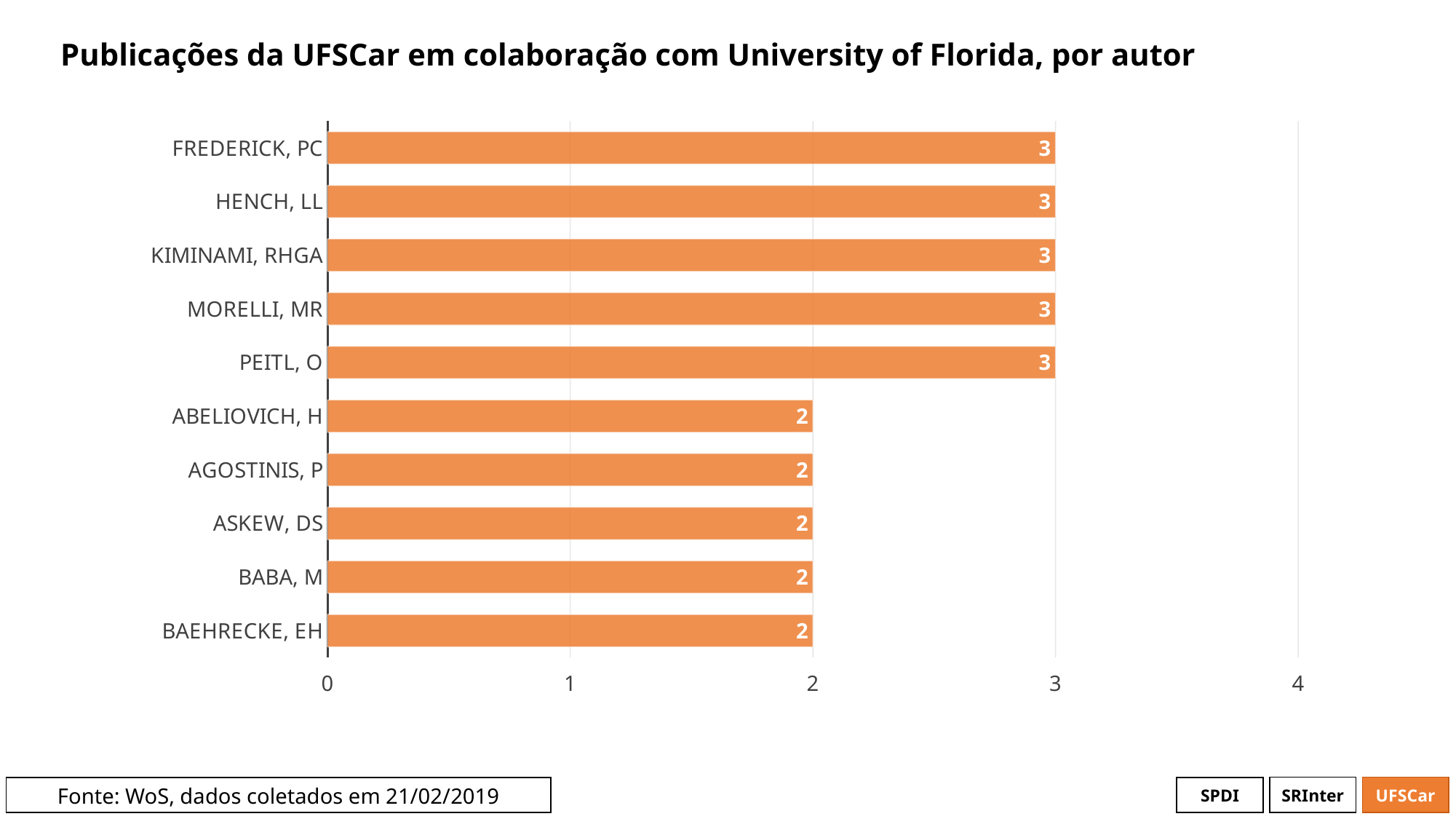
What is the value for PEITL, O? 3 What is the difference between the values for HENCH, LL and ASKEW, DS? 1 What kind of chart is shown on the slide? bar chart What colour are the bars in the chart? orange Is the value for KIMINAMI, RHGA greater or less than 2? greater What is the title of the chart? Publicações da UFSCar em colaboração com University of Florida, por autor Which is larger, the value for MORELLI, MR or the value for BABA, M? MORELLI, MR What is the value for FREDERICK, PC? 3 Is the value for AGOSTINIS, P greater or less than 3? less What is the value for ABELIOVICH, H? 2 What is the value for BAEHRECKE, EH? 2 How many authors are shown in the chart? 10